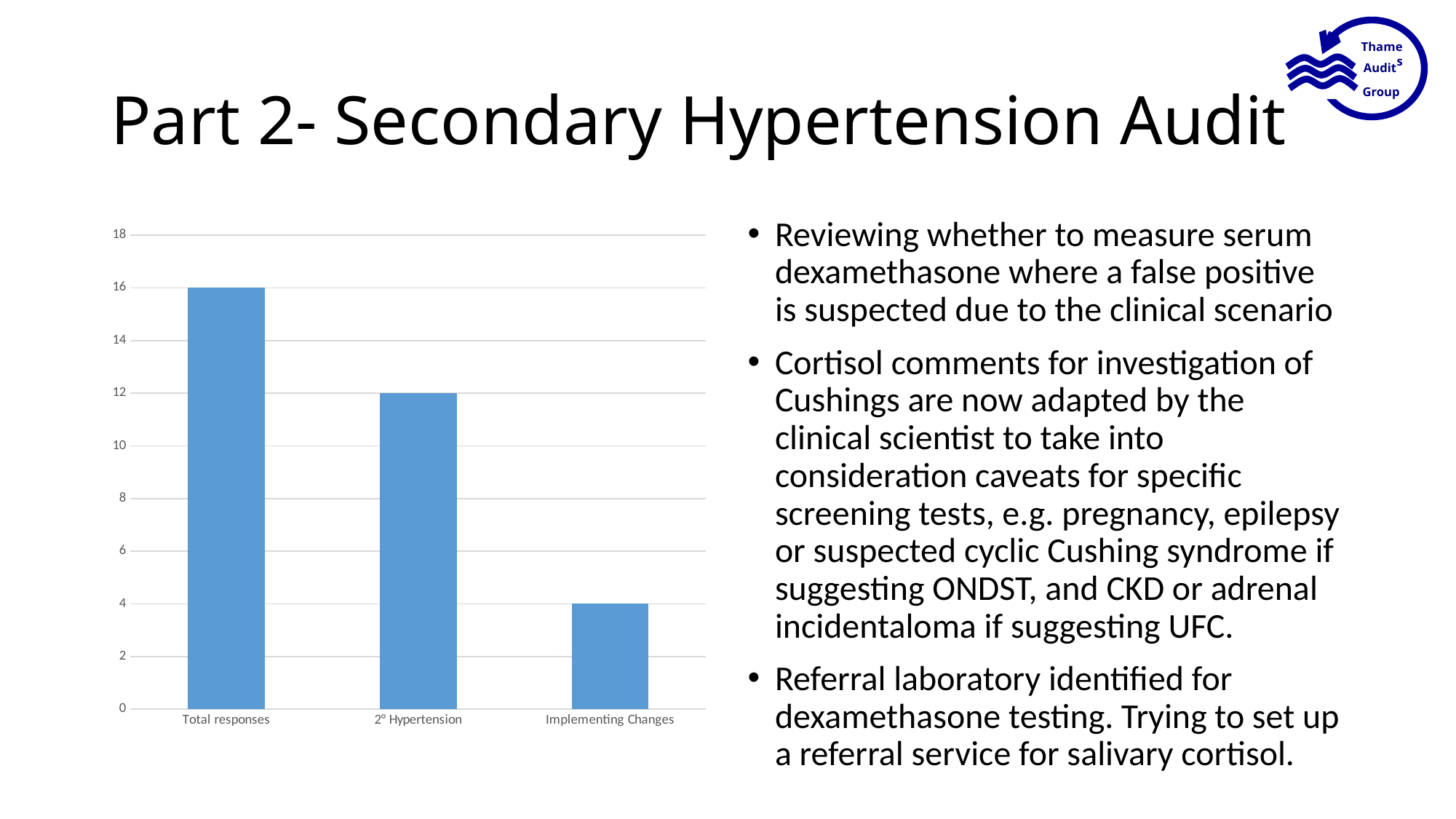
How many categories are shown on the chart? 3 What kind of chart is shown on the slide? bar chart What is the value for Total responses? 16 Which category has the lowest value? Implementing Changes What is the value for Implementing Changes? 4 Which is larger, 2° Hypertension or Implementing Changes? 2° Hypertension Which category has the highest value? Total responses Do the values rise or fall from left to right across the categories? fall Is the value for Implementing Changes greater or less than 6? less What is the difference between 2° Hypertension and Implementing Changes? 8 What is the value for 2° Hypertension? 12 What is the difference between Total responses and 2° Hypertension? 4